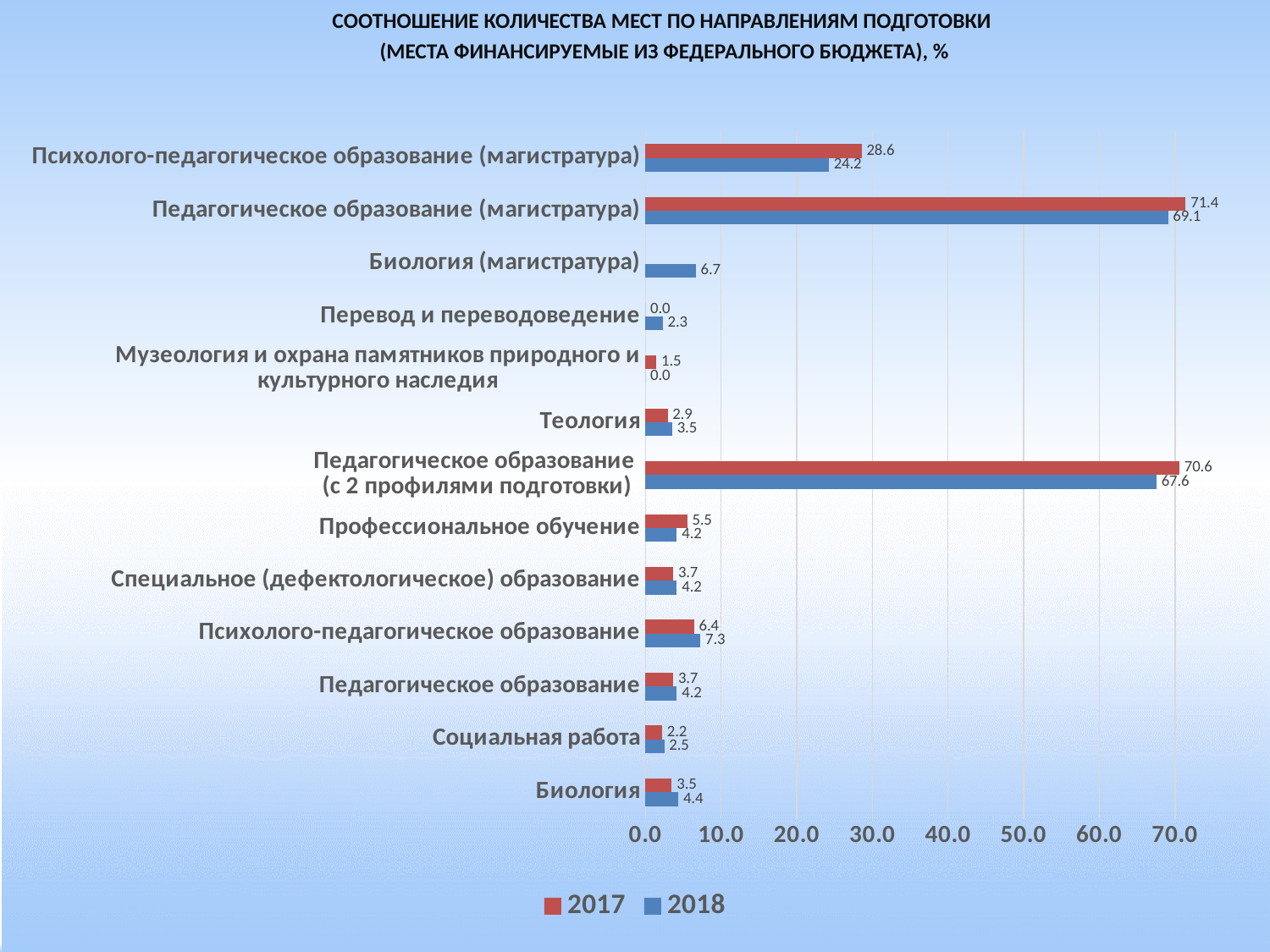
What kind of chart is shown on the slide? Bar chart What is the difference between the 2017 and 2018 values for Педагогическое образование (с 2 профилями подготовки)? 3.0 How many series does the legend list? 2 What is the 2018 value for Биология (магистратура)? 6.7 Which is larger for Психолого-педагогическое образование: the 2017 value or the 2018 value? 2018 Which colour represents the 2017 series? Red Is the 2017 value for Психолого-педагогическое образование (магистратура) greater or less than 20.0? greater How many categories are shown on the chart? 13 Which category has the highest 2018 value? Педагогическое образование (магистратура) Which category has the lowest 2017 value? Перевод и переводоведение What is the 2018 value for Психолого-педагогическое образование (магистратура)? 24.2 What is the 2017 value for Педагогическое образование (магистратура)? 71.4